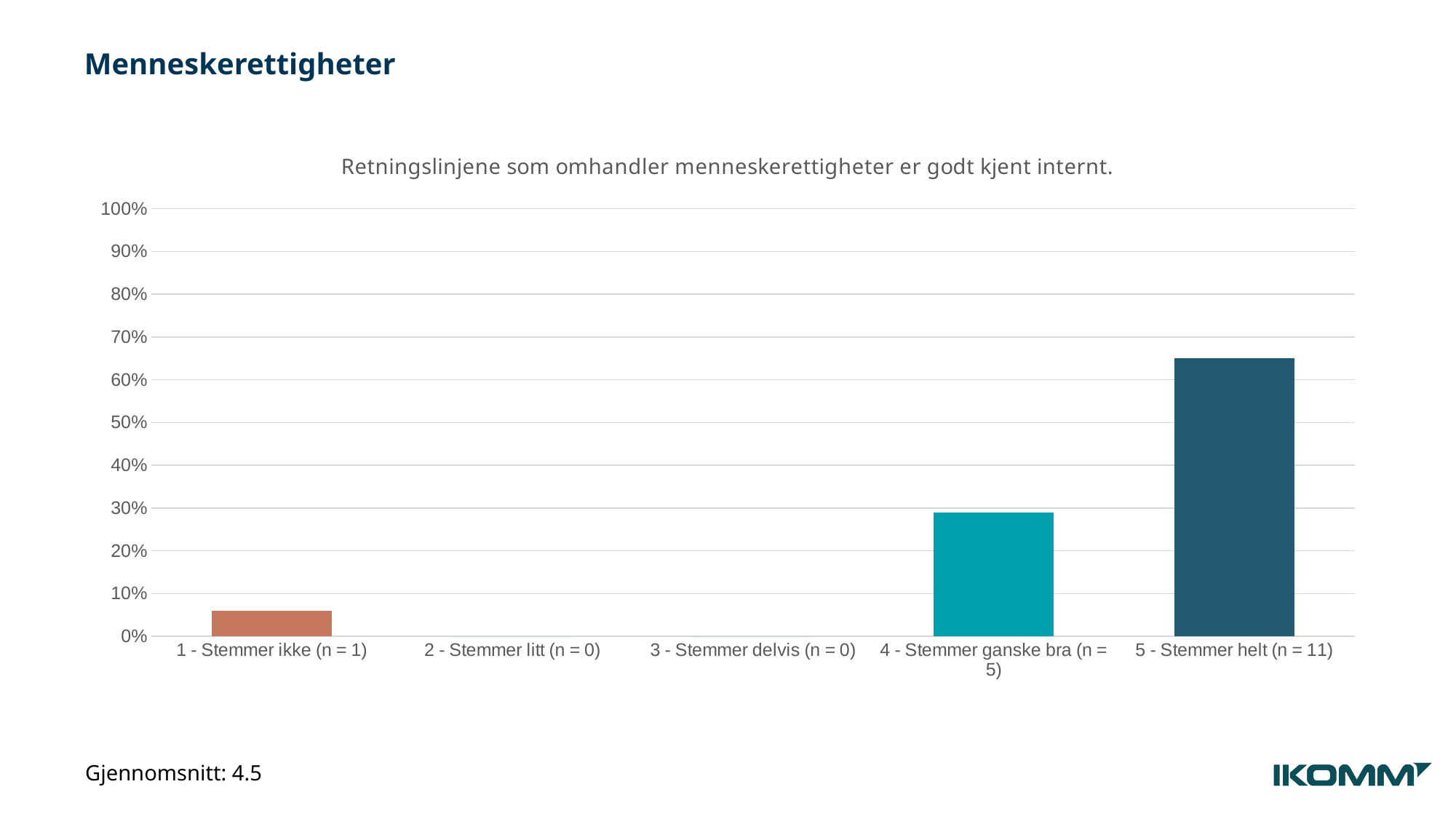
Is the value for 4 - Stemmer ganske bra greater or less than 20%? greater Which is larger, the value for 1 - Stemmer ikke or the value for 4 - Stemmer ganske bra? 4 - Stemmer ganske bra Is the value for 5 - Stemmer helt greater or less than 60%? greater What is the value for 2 - Stemmer litt? 0% Which category has the highest bar? 5 - Stemmer helt (n = 11) What is the title of the chart? Retningslinjene som omhandler menneskerettigheter er godt kjent internt. How many categories are shown on the x axis of the chart? 5 Is the value for 5 - Stemmer helt greater or less than 70%? less What kind of chart is shown on the slide? bar chart Which is larger, the value for 4 - Stemmer ganske bra or the value for 5 - Stemmer helt? 5 - Stemmer helt